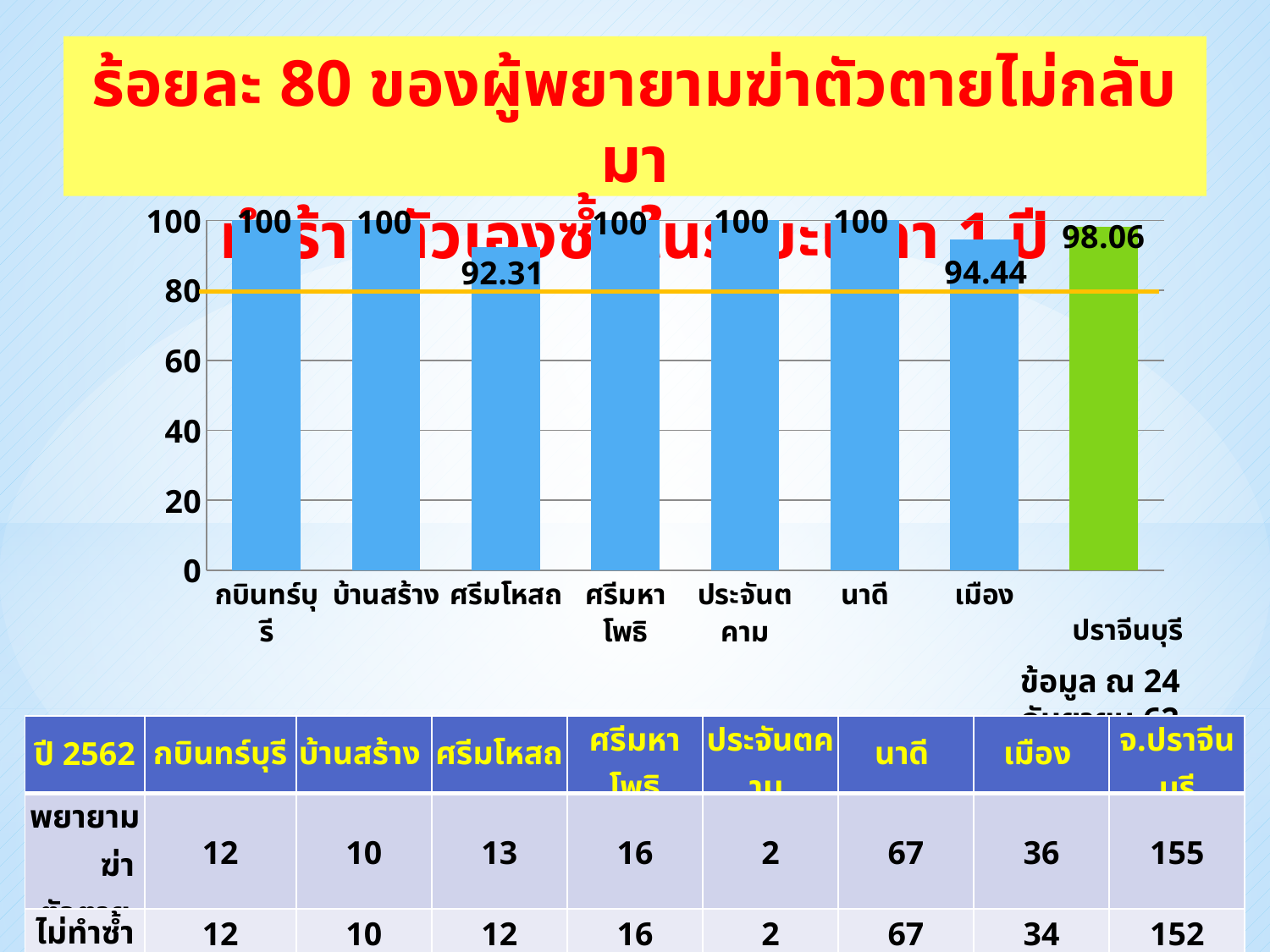
What is the value for ปราจีนบุรี? 98.06 What is the value for นาดี? 100 What is the value for เมือง? 94.44 What is the value for ศรีมโหสถ? 92.31 Which category has the lowest value? ศรีมโหสถ Which is larger, the value for เมือง or the value for ศรีมโหสถ? เมือง What kind of chart is shown on the slide? bar chart Which bar is coloured green rather than blue? ปราจีนบุรี What is the difference between the values for ปราจีนบุรี and ศรีมโหสถ? 5.75 Is the value for ศรีมโหสถ greater or less than 80? greater How many bars are shown in the chart? 8 What is the difference between the values for กบินทร์บุรี and เมือง? 5.56